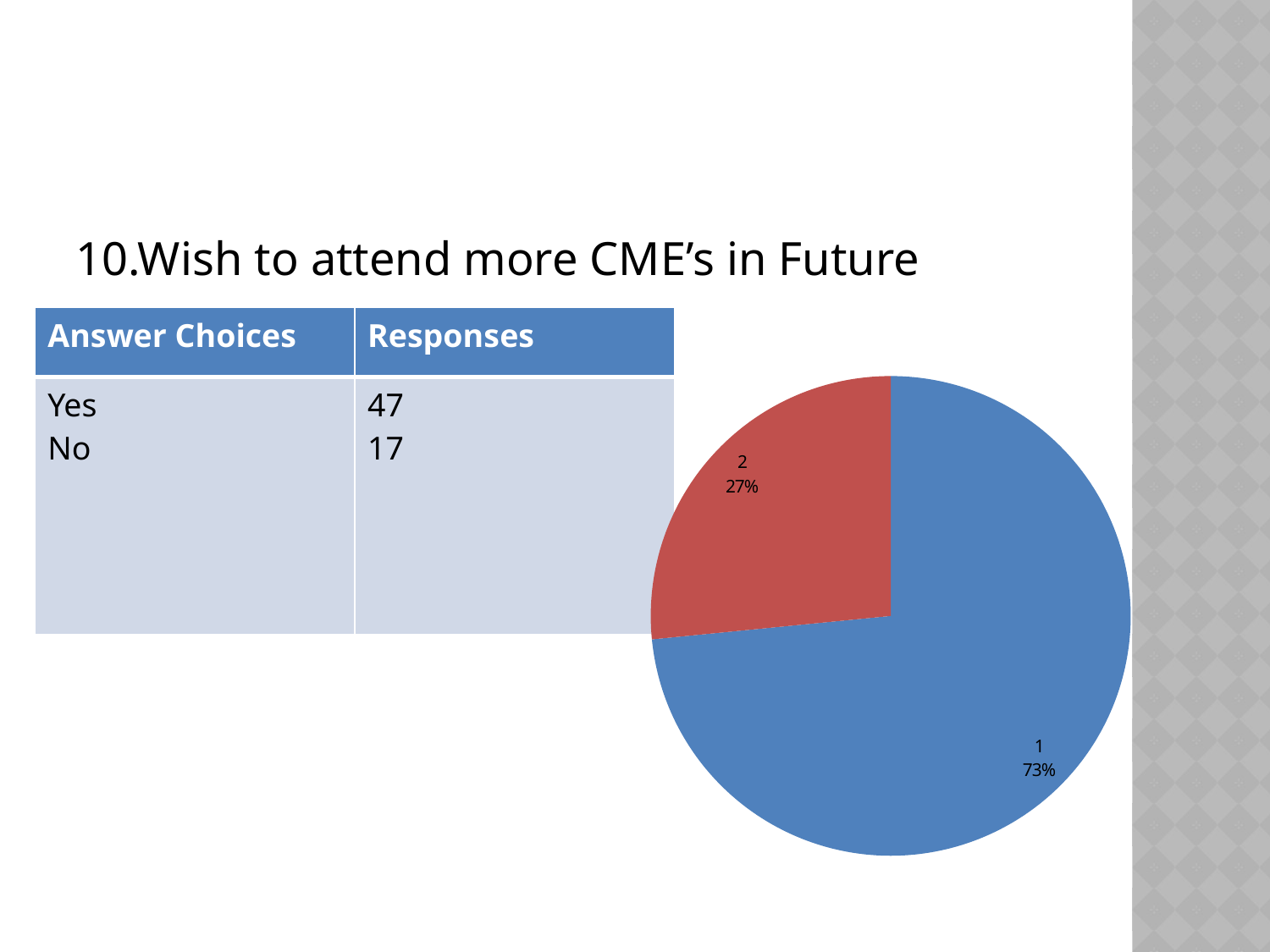
What share of the pie does slice 2 represent? 27% What share of the pie does slice 1 represent? 73% What colour is slice 2 in the pie chart? red Which slice is larger, slice 1 or slice 2? slice 1 Which slice of the pie chart is the largest? 1 What kind of chart is shown on the slide? pie chart Which slice of the pie chart is the smallest? 2 Is the share for slice 1 greater or less than 50%? greater What is the difference in percentage points between slice 1 and slice 2? 46 percentage points How many slices does the pie chart have? 2 What colour is slice 1 in the pie chart? blue